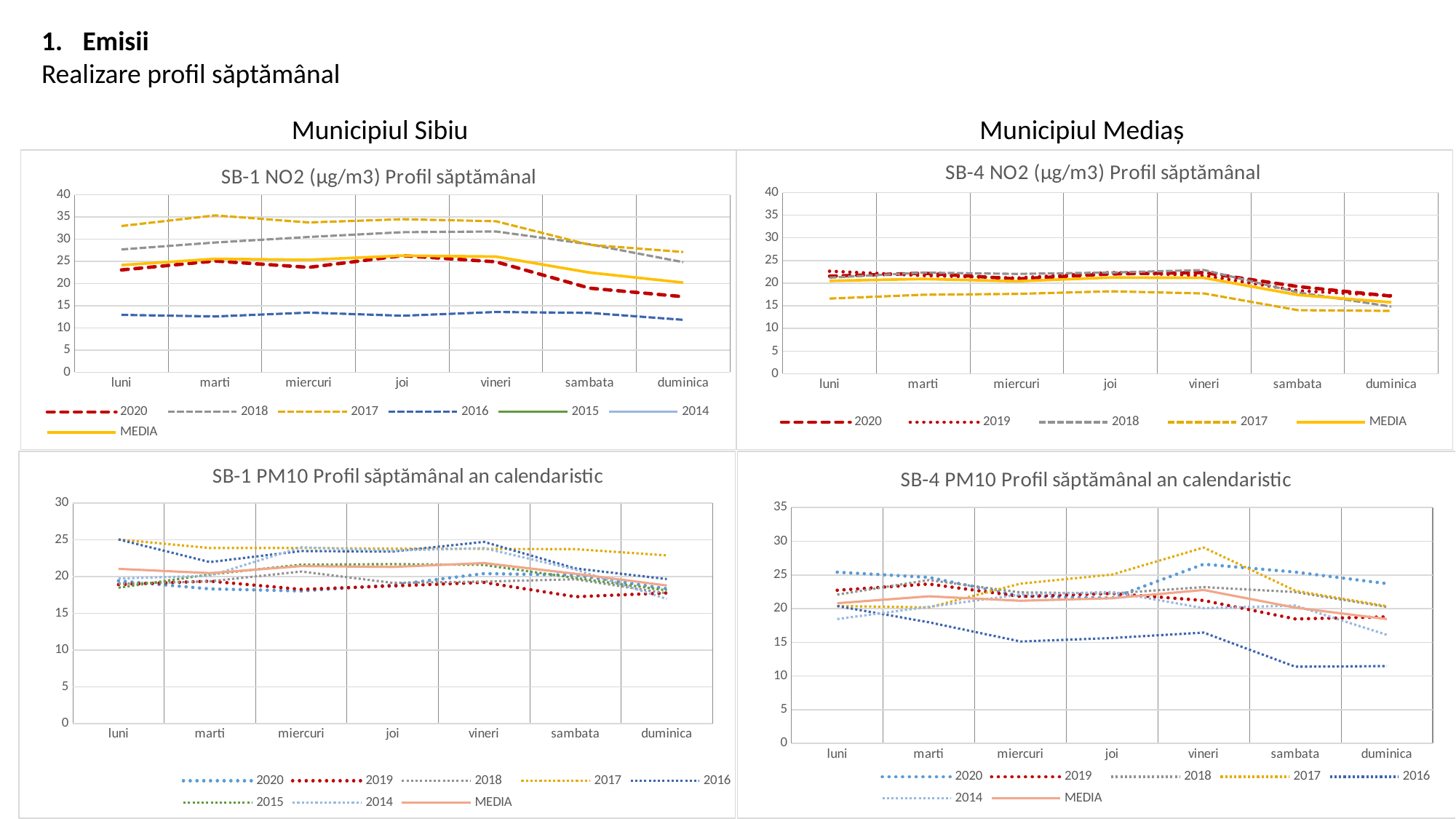
In the 'SB-4 PM10 Profil săptămânal an calendaristic' chart, is the value for 2017 on vineri greater or less than 25? greater In the 'SB-1 NO2 (µg/m3) Profil săptămânal' chart, which series has the lowest values across the week? 2016 In the 'SB-1 PM10 Profil săptămânal an calendaristic' chart, how many categories are on the x axis? 7 How many charts are shown on the slide? 4 In the 'SB-1 NO2 (µg/m3) Profil săptămânal' chart, which series has the highest values across the week? 2017 In the 'SB-4 PM10 Profil săptămânal an calendaristic' chart, which series has the lowest values on duminica? 2016 In the 'SB-4 NO2 (µg/m3) Profil săptămânal' chart, do the MEDIA values rise or fall from vineri to duminica? fall What kind of chart is the 'SB-1 NO2 (µg/m3) Profil săptămânal' chart? line chart In the 'SB-4 NO2 (µg/m3) Profil săptămânal' chart, is the value for 2017 on luni greater or less than 20? less In the 'SB-4 NO2 (µg/m3) Profil săptămânal' chart, how many series does the legend list? 5 In the 'SB-1 NO2 (µg/m3) Profil săptămânal' chart, how many series does the legend list? 7 In the 'SB-1 NO2 (µg/m3) Profil săptămânal' chart, is the value for 2017 on marti greater or less than 30? greater